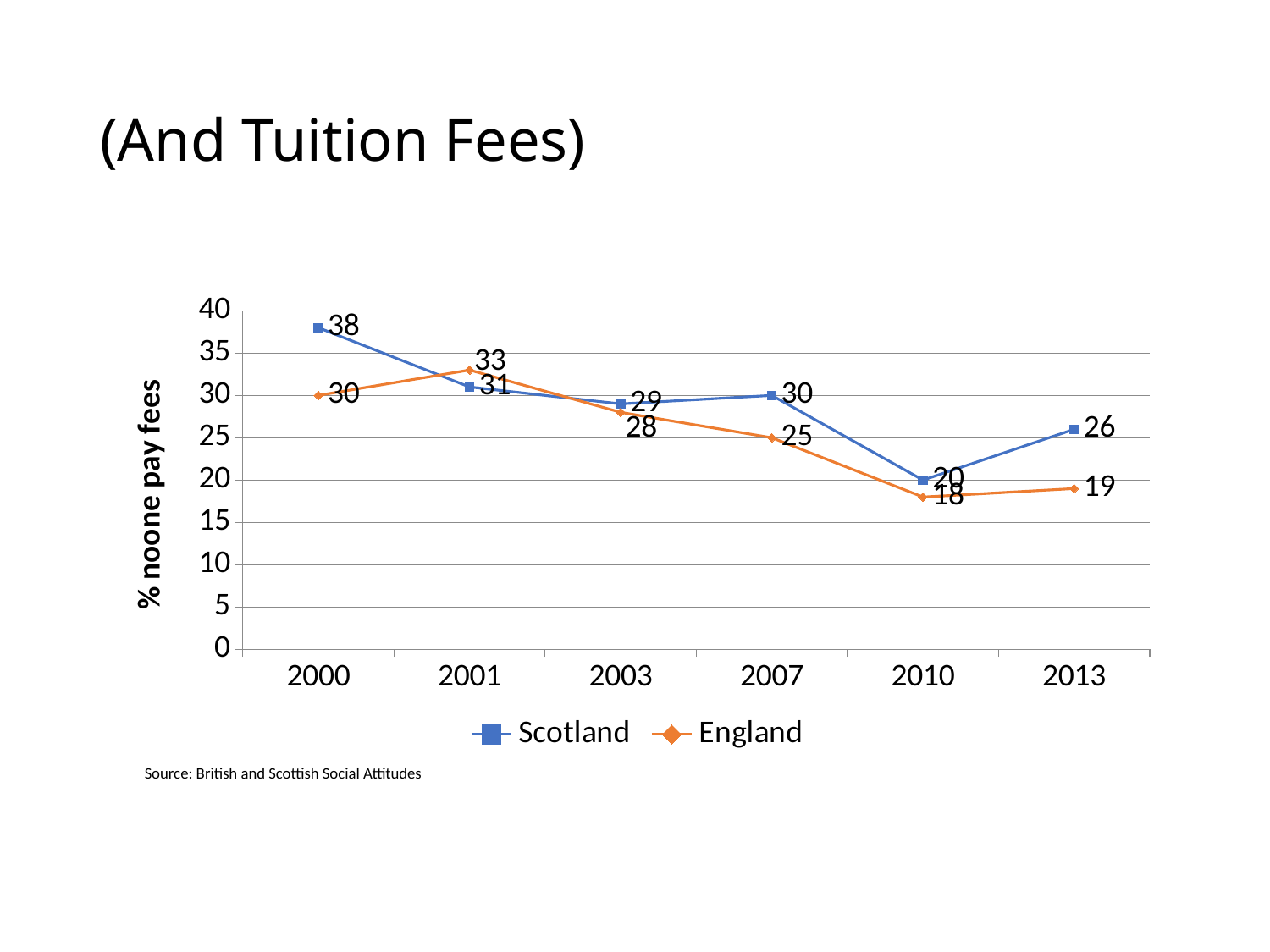
In which year is the Scotland value highest? 2000 In which year is the England value lowest? 2010 What kind of chart is shown on the slide? Line chart What is the difference between the Scotland and England values in 2013? 7 What is the value for Scotland in 2000? 38 What is the value for Scotland in 2013? 26 How many series does the legend list? 2 How many years are shown on the x axis? 6 Which is larger in 2001, the Scotland value or the England value? England What is the value for England in 2010? 18 What is the label of the y axis? % noone pay fees What is the value for England in 2001? 33